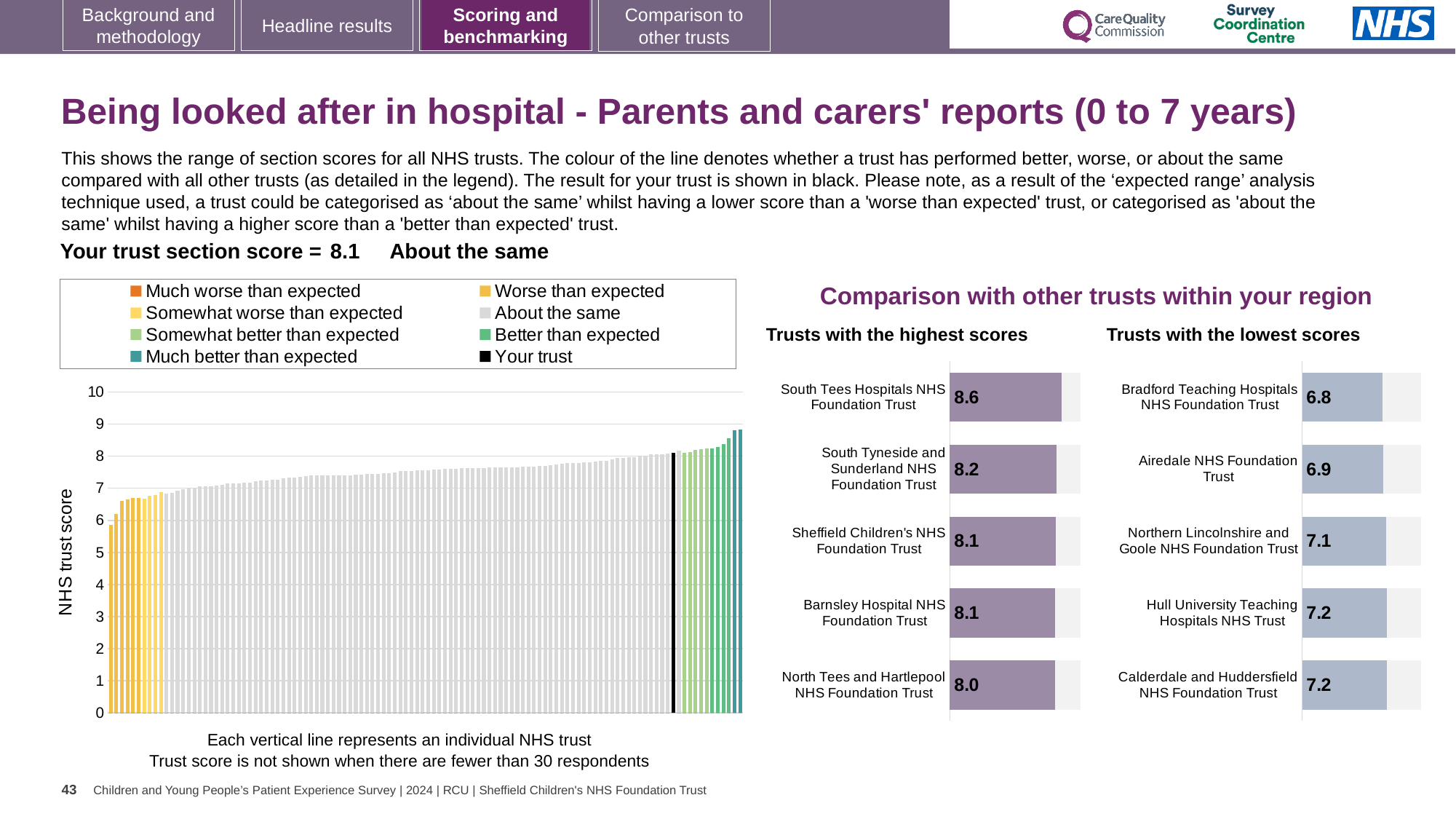
In the 'Trusts with the highest scores' chart, what is the score for South Tees Hospitals NHS Foundation Trust? 8.6 In the 'Trusts with the highest scores' chart, how many trusts are listed? 5 In the large chart on the left, is the value of the tallest bar greater or less than 8? greater In the 'Trusts with the highest scores' chart, what is the difference between the scores of South Tees Hospitals NHS Foundation Trust and North Tees and Hartlepool NHS Foundation Trust? 0.6 In the 'Trusts with the lowest scores' chart, which has the higher score: Hull University Teaching Hospitals NHS Trust or Northern Lincolnshire and Goole NHS Foundation Trust? Hull University Teaching Hospitals NHS Trust What kind of chart is the large chart on the left with the y-axis labelled 'NHS trust score'? Bar chart How many entries does the legend above the large chart on the left list? 8 In the 'Trusts with the lowest scores' chart, what is the difference between the scores of Airedale NHS Foundation Trust and Bradford Teaching Hospitals NHS Foundation Trust? 0.1 In the large chart on the left, do the trust scores rise or fall from left to right along the x axis? Rise In the 'Trusts with the highest scores' chart, which trust has the lowest score? North Tees and Hartlepool NHS Foundation Trust In the 'Trusts with the lowest scores' chart, which trust has the lowest score? Bradford Teaching Hospitals NHS Foundation Trust In the 'Trusts with the lowest scores' chart, what is the score for Airedale NHS Foundation Trust? 6.9